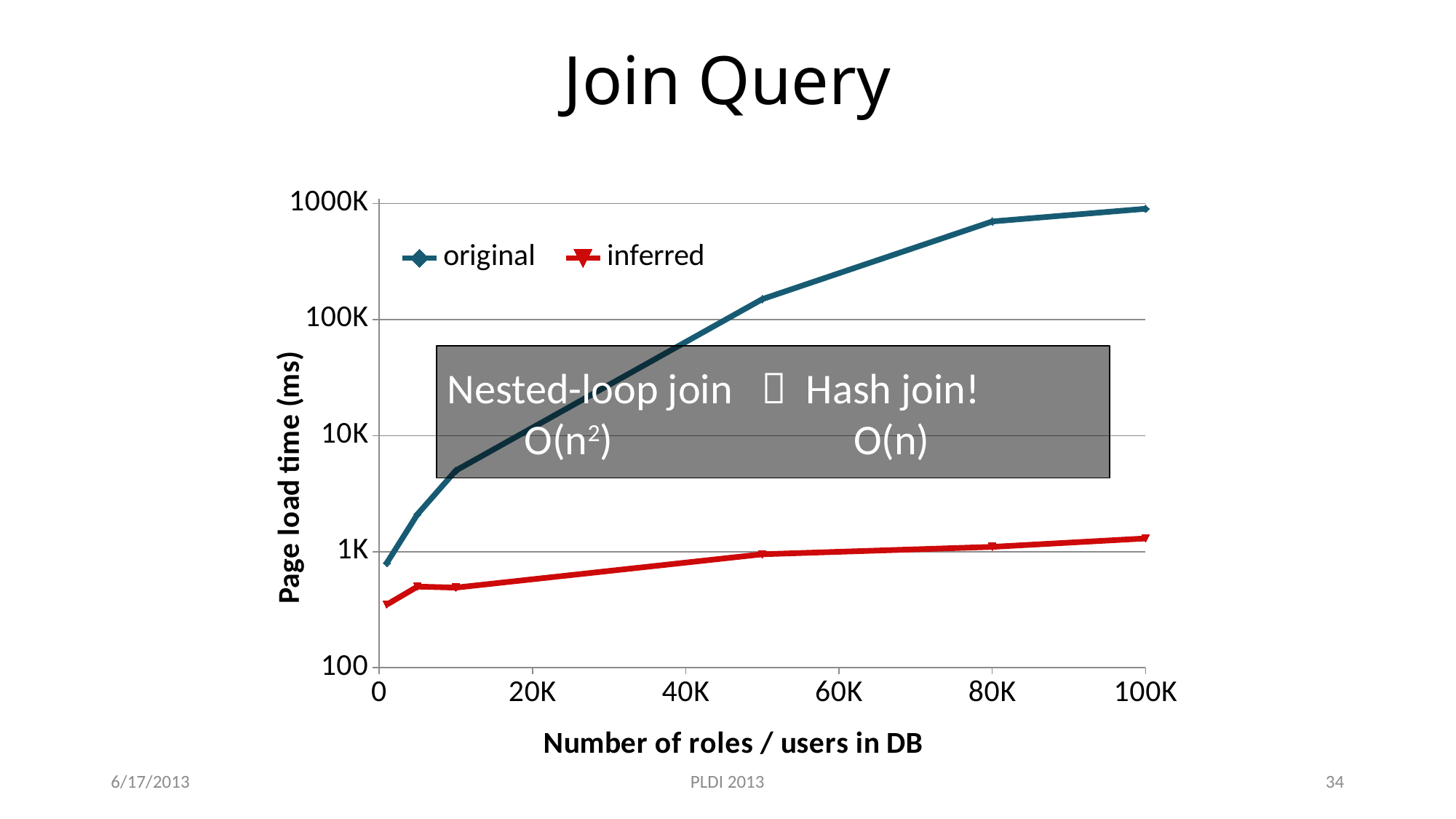
How many series does the legend list? 2 Is the value for the original series at 10K greater or less than 1K ms? greater Is the value for the inferred series at 100K greater or less than 10K ms? less What is the label of the y axis? Page load time (ms) What are the two series named in the legend? original and inferred Is the value for the inferred series at 10K greater or less than 1K ms? less At 100K roles/users, which series has the higher page load time, original or inferred? original Which series reaches the highest page load time on the chart? original Does the original series rise or fall as the number of roles/users increases? rise What kind of chart is shown on the slide? line chart